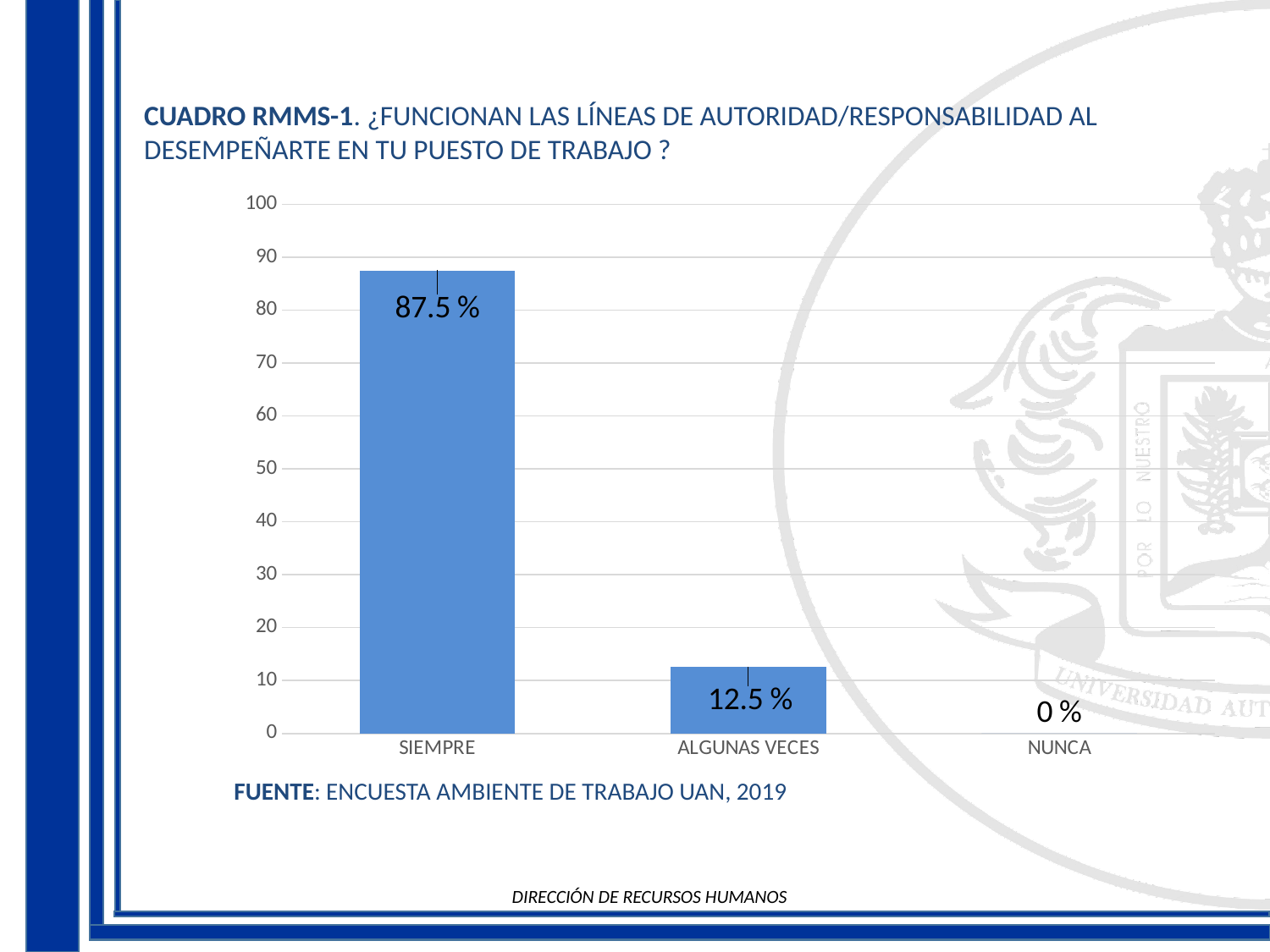
What source is cited below the chart? ENCUESTA AMBIENTE DE TRABAJO UAN, 2019 Which category has the highest value? SIEMPRE Is the value for ALGUNAS VECES greater or less than 20? less What kind of chart is shown on the slide? bar chart Is the value for SIEMPRE greater or less than 80? greater What is the difference between the values for SIEMPRE and ALGUNAS VECES? 75 % What is the value for ALGUNAS VECES? 12.5 % Which is larger, the value for ALGUNAS VECES or the value for NUNCA? ALGUNAS VECES What is the value for NUNCA? 0 % Which category has the lowest value? NUNCA What is the value for SIEMPRE? 87.5 % How many categories are shown on the x axis? 3